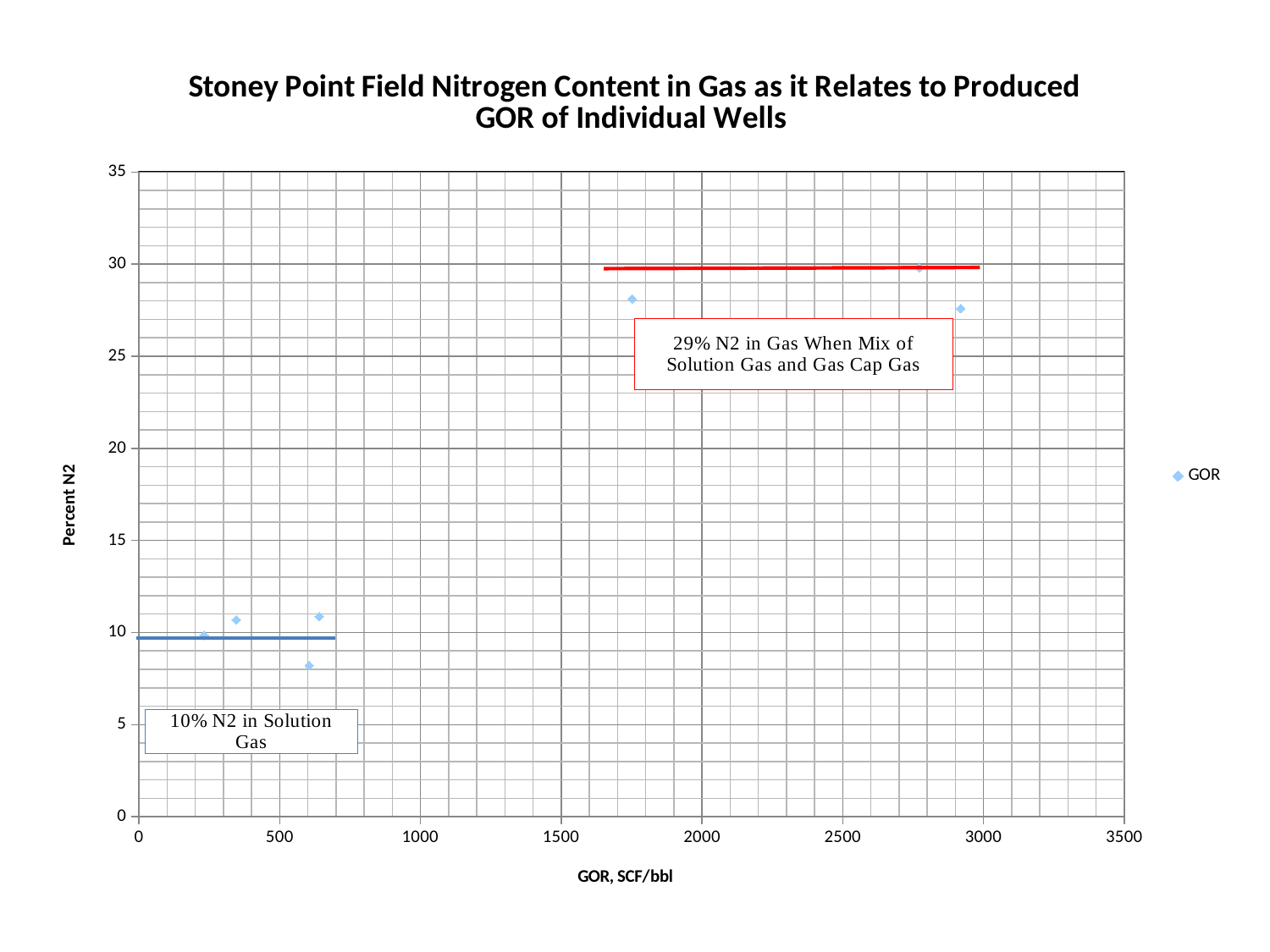
Is the Percent N2 value for the point near a GOR of 350 SCF/bbl greater or less than 15? less How many series does the legend list? 1 Do the Percent N2 values generally rise or fall as GOR increases along the x axis? rise What kind of chart is shown on the slide? scatter chart What is the name of the series listed in the legend? GOR Which group of points has higher Percent N2 values: those with GOR below 1000 SCF/bbl or those with GOR above 1500 SCF/bbl? those with GOR above 1500 SCF/bbl Is the Percent N2 value for the point near a GOR of 1750 SCF/bbl greater or less than 25? greater Is the Percent N2 value for the point near a GOR of 2900 SCF/bbl greater or less than 20? greater According to the annotation, what percent N2 is in gas when it is a mix of solution gas and gas cap gas? 29% According to the annotation, what percent N2 is in solution gas? 10% What is the title of the chart? Stoney Point Field Nitrogen Content in Gas as it Relates to Produced GOR of Individual Wells